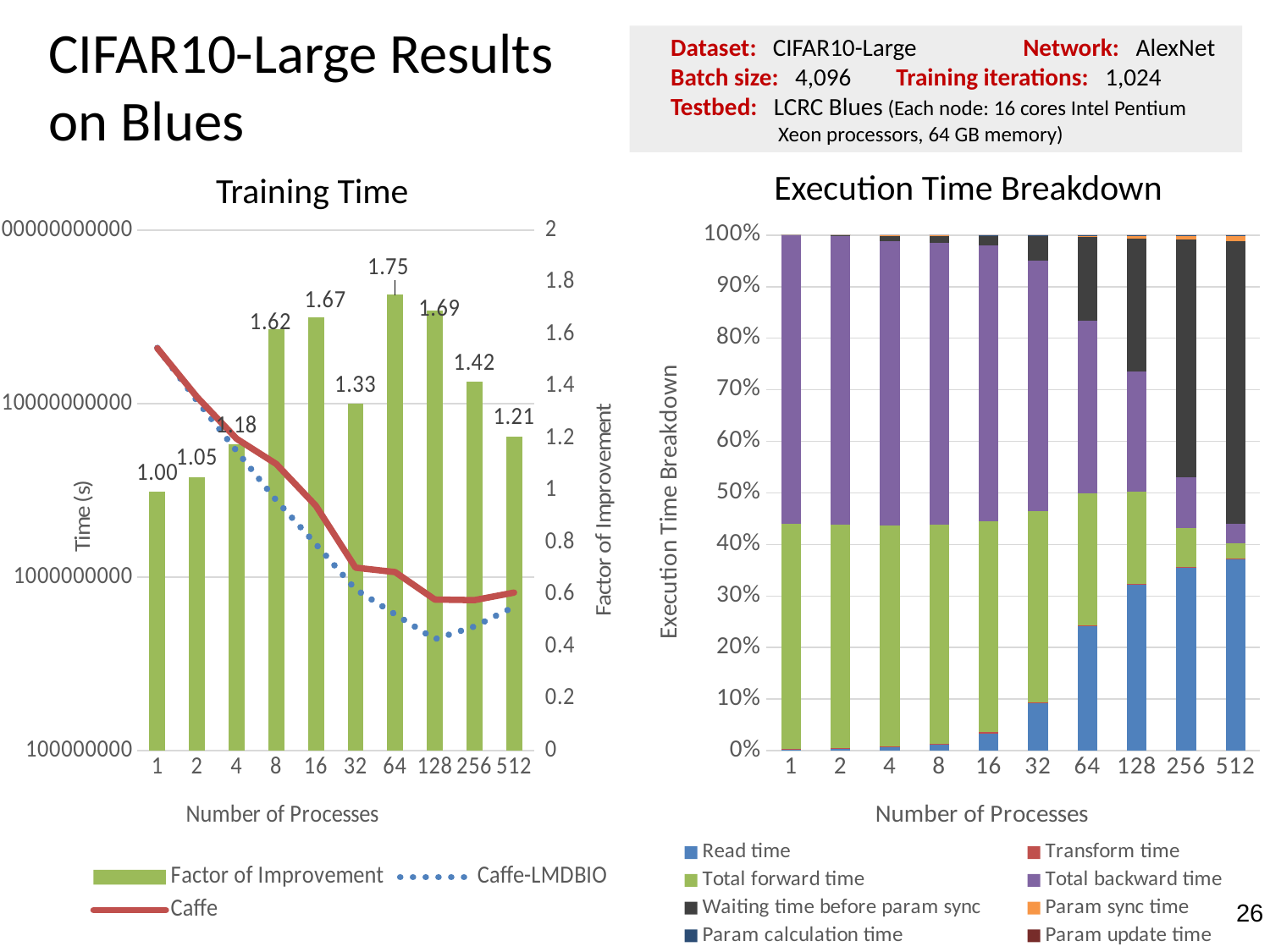
In the Training Time chart, how many series does the legend list? 3 In the Training Time chart, at which number of processes is the Factor of Improvement highest? 64 In the Training Time chart, which has the larger Factor of Improvement: 8 processes or 16 processes? 16 processes In the Training Time chart, what is the Factor of Improvement at 64 processes? 1.75 In the Training Time chart, at which number of processes is the Factor of Improvement lowest? 1 In the Execution Time Breakdown chart, is the Read time share at 512 processes greater or less than 30%? greater What kind of chart is the Execution Time Breakdown chart? stacked bar chart In the Training Time chart, what is the Factor of Improvement at 512 processes? 1.21 In the Execution Time Breakdown chart, how many series does the legend list? 8 In the Training Time chart, does the Caffe line rise or fall from 1 process to 32 processes? falls In the Training Time chart, how many Number of Processes categories are shown on the x axis? 10 In the Training Time chart, what is the difference between the Factor of Improvement at 64 processes and at 1 process? 0.75